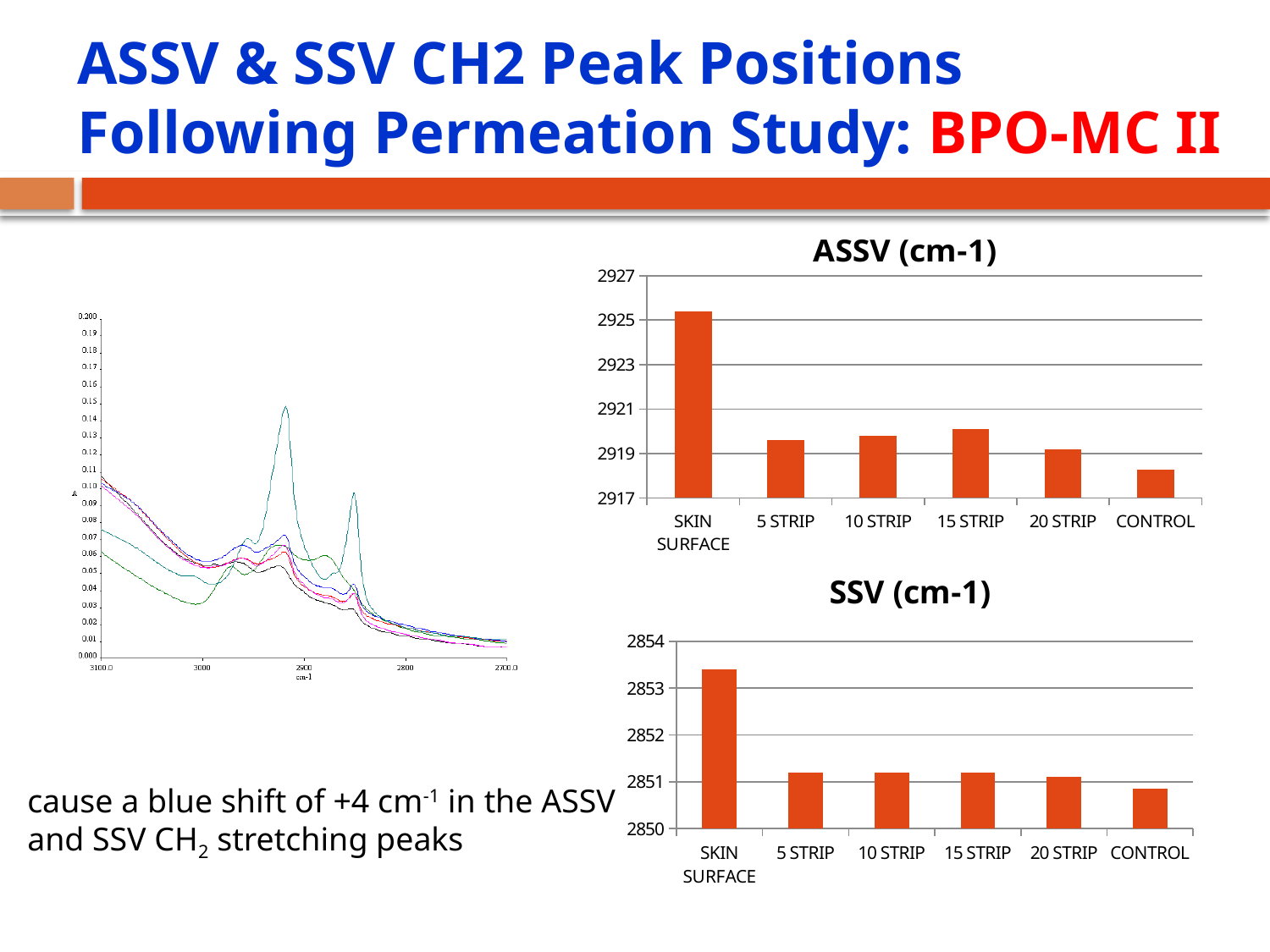
What kind of chart is the SSV (cm-1) chart? bar chart How many categories are shown in the ASSV (cm-1) chart? 6 In the ASSV (cm-1) chart, which is larger, the value for 20 STRIP or the value for CONTROL? 20 STRIP In the SSV (cm-1) chart, which category has the highest value? SKIN SURFACE In the ASSV (cm-1) chart, is the value for SKIN SURFACE greater or less than 2923? greater In the SSV (cm-1) chart, is the value for CONTROL greater or less than 2851? less In the ASSV (cm-1) chart, is the value for CONTROL greater or less than 2919? less In the ASSV (cm-1) chart, which category has the lowest value? CONTROL What is the title of the top chart on the right side of the slide? ASSV (cm-1) In the SSV (cm-1) chart, which category has the lowest value? CONTROL In the ASSV (cm-1) chart, which category has the highest value? SKIN SURFACE